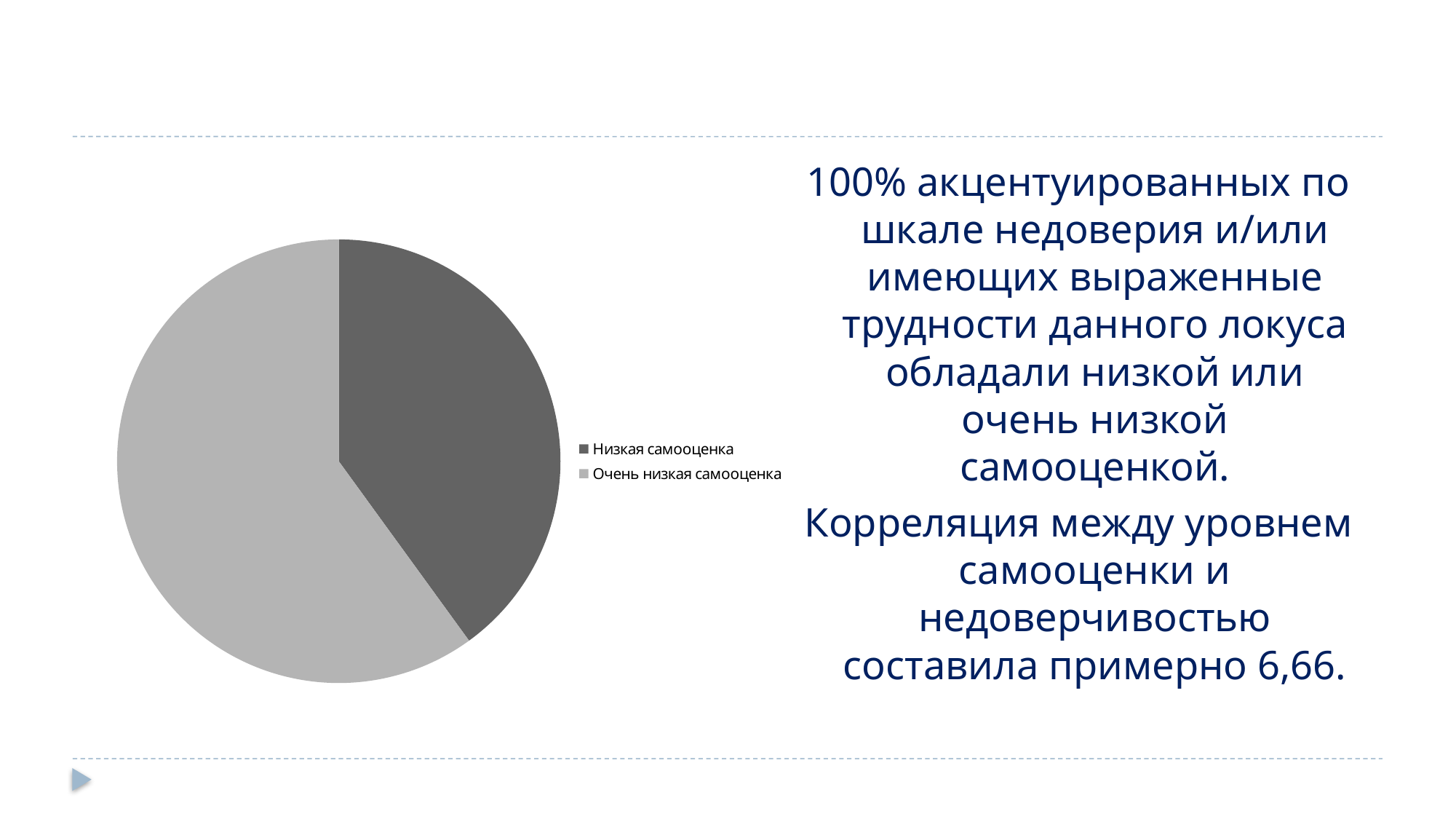
Which legend entry is shown in light gray? Очень низкая самооценка Which category has the smallest slice in the pie chart? Низкая самооценка What kind of chart is shown on the slide? pie chart Does the slice for "Очень низкая самооценка" take up more or less than half of the pie? more How many entries does the legend of the pie chart list? 2 Which slice is larger: "Низкая самооценка" or "Очень низкая самооценка"? Очень низкая самооценка Which category has the largest slice in the pie chart? Очень низкая самооценка Which colour represents "Низкая самооценка" in the pie chart? dark gray How many slices does the pie chart have? 2